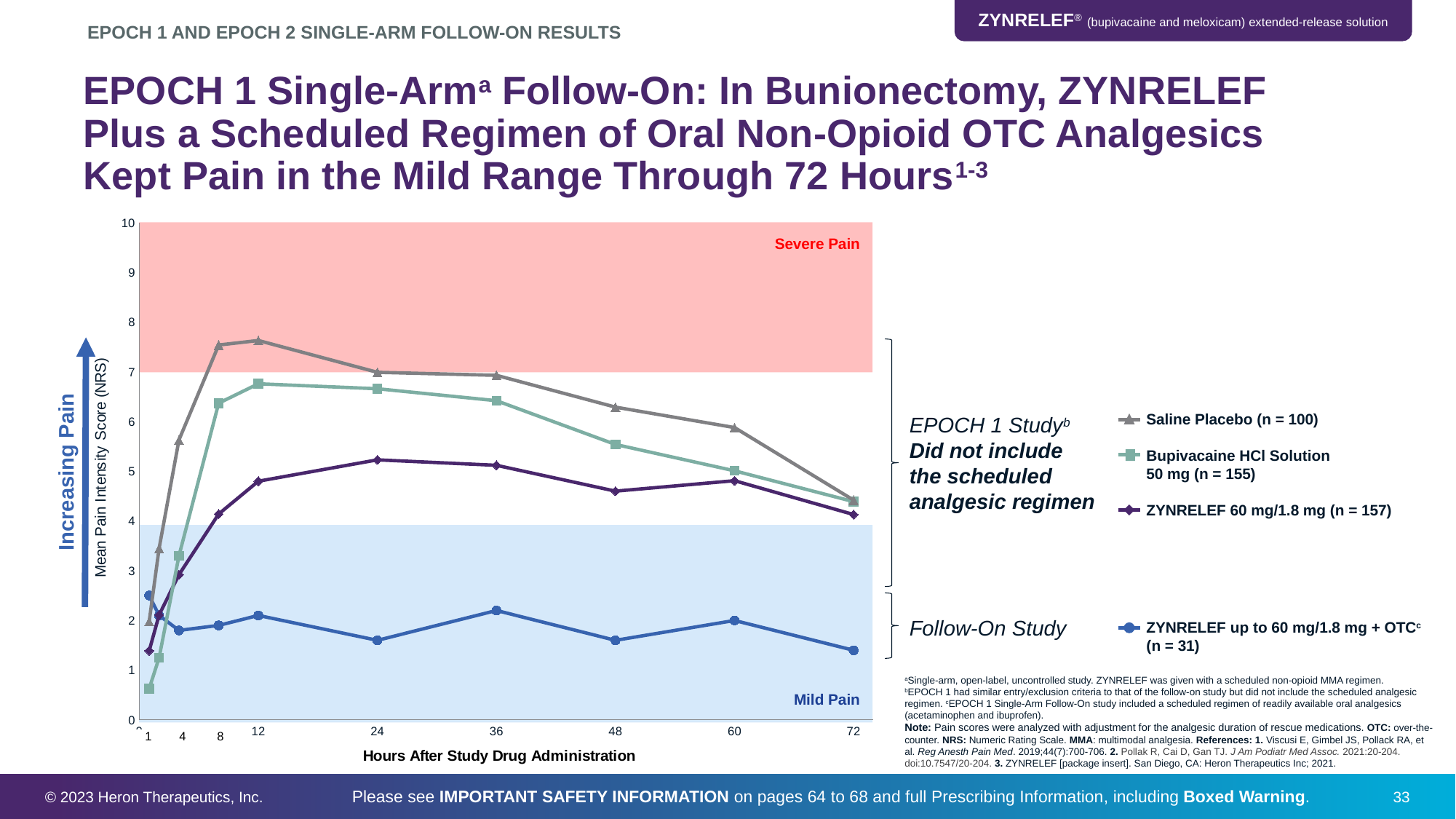
Does the Saline Placebo series rise or fall from 12 hours to 72 hours? fall Is the value for Bupivacaine HCl Solution 50 mg at 12 hours greater or less than 7? less Is the value for ZYNRELEF up to 60 mg/1.8 mg + OTC at 72 hours greater or less than 2? less Is the value for Saline Placebo at 12 hours greater or less than 7? greater Which series has the lowest mean pain intensity score at 48 hours? ZYNRELEF up to 60 mg/1.8 mg + OTC (n = 31) What is the label of the red shaded region at the top of the chart? Severe Pain How many series does the chart's legend list? 4 How many time points are labelled on the x axis of the chart? 9 Which series has the highest mean pain intensity score at 12 hours? Saline Placebo (n = 100) At 24 hours, which is larger: the value for Saline Placebo or the value for ZYNRELEF up to 60 mg/1.8 mg + OTC? Saline Placebo What kind of chart is shown on the slide? line chart